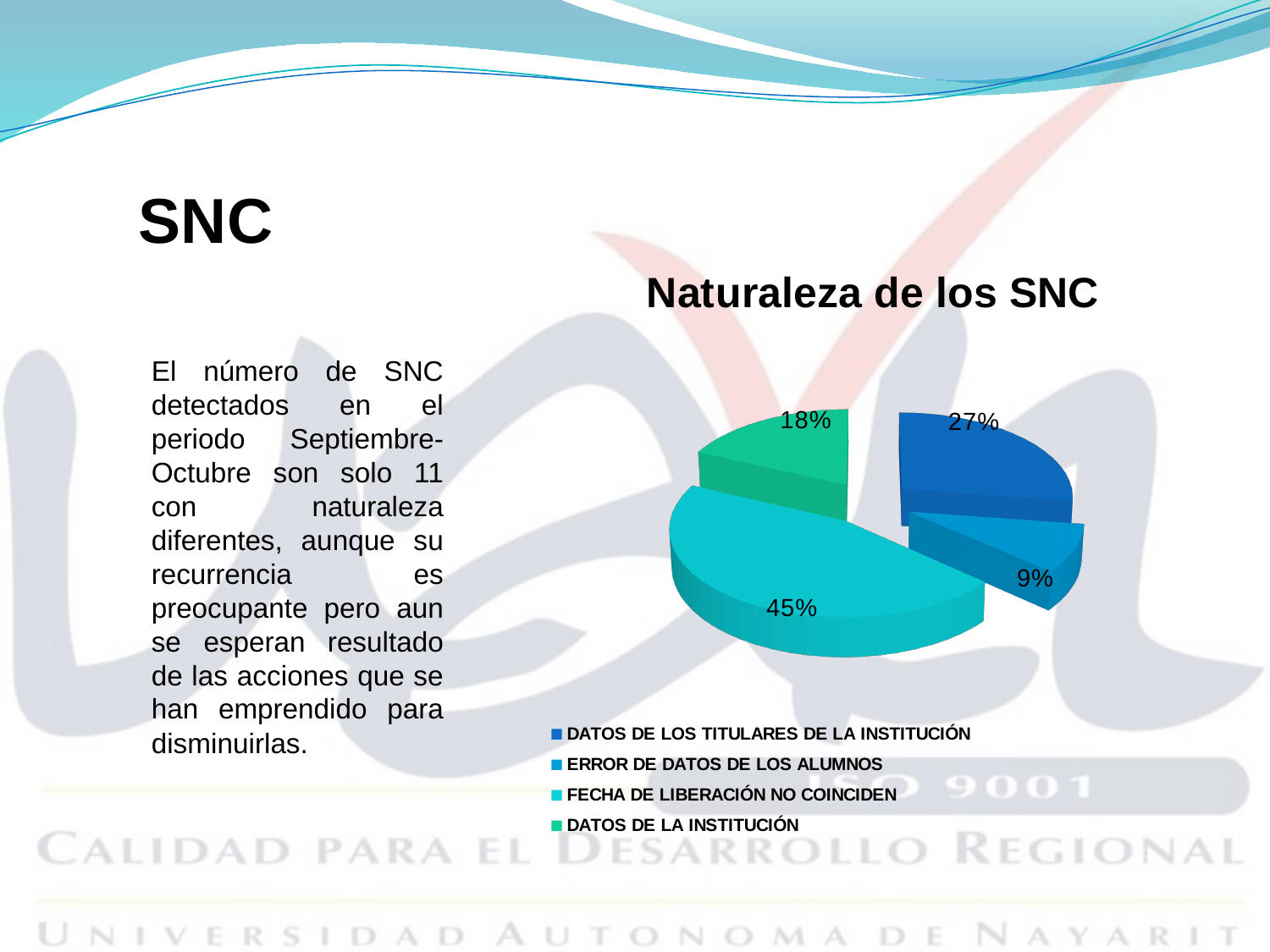
What share of the pie is DATOS DE LOS TITULARES DE LA INSTITUCIÓN? 27% Which is larger, the share for DATOS DE LA INSTITUCIÓN or the share for ERROR DE DATOS DE LOS ALUMNOS? DATOS DE LA INSTITUCIÓN What is the title of the chart? Naturaleza de los SNC What kind of chart is shown on the slide? pie chart What share of the pie is DATOS DE LA INSTITUCIÓN? 18% Which category has the largest share of the pie? FECHA DE LIBERACIÓN NO COINCIDEN Which category has the smallest share of the pie? ERROR DE DATOS DE LOS ALUMNOS What share of the pie is ERROR DE DATOS DE LOS ALUMNOS? 9% How many slices does the pie chart have? 4 What is the difference in percentage points between FECHA DE LIBERACIÓN NO COINCIDEN and DATOS DE LOS TITULARES DE LA INSTITUCIÓN? 18 How many entries does the legend list? 4